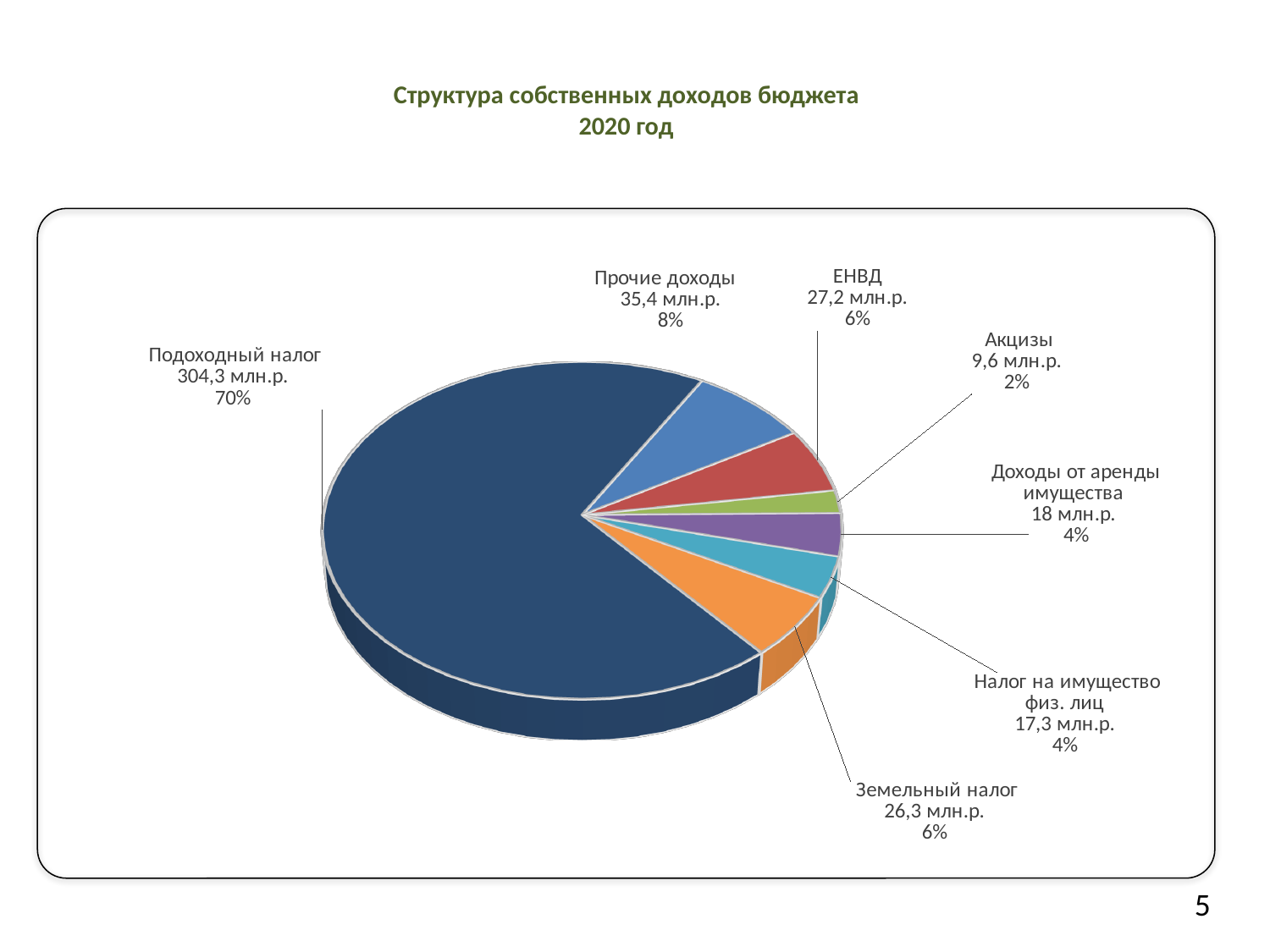
What is the value for ЕНВД? 27,2 млн.р. Which category has the smallest slice? Акцизы What share of the pie does Акцизы take? 2% What kind of chart is shown on the slide? Pie chart Which category has the largest slice? Подоходный налог Which is larger, Налог на имущество физ. лиц or Земельный налог? Земельный налог What is the value for Прочие доходы? 35,4 млн.р. What is the value for Доходы от аренды имущества? 18 млн.р. What share of the pie does Подоходный налог take? 70% What is the value for Подоходный налог? 304,3 млн.р. What is the difference between the values for ЕНВД and Земельный налог? 0,9 млн.р. How many categories are shown in the pie chart? 7